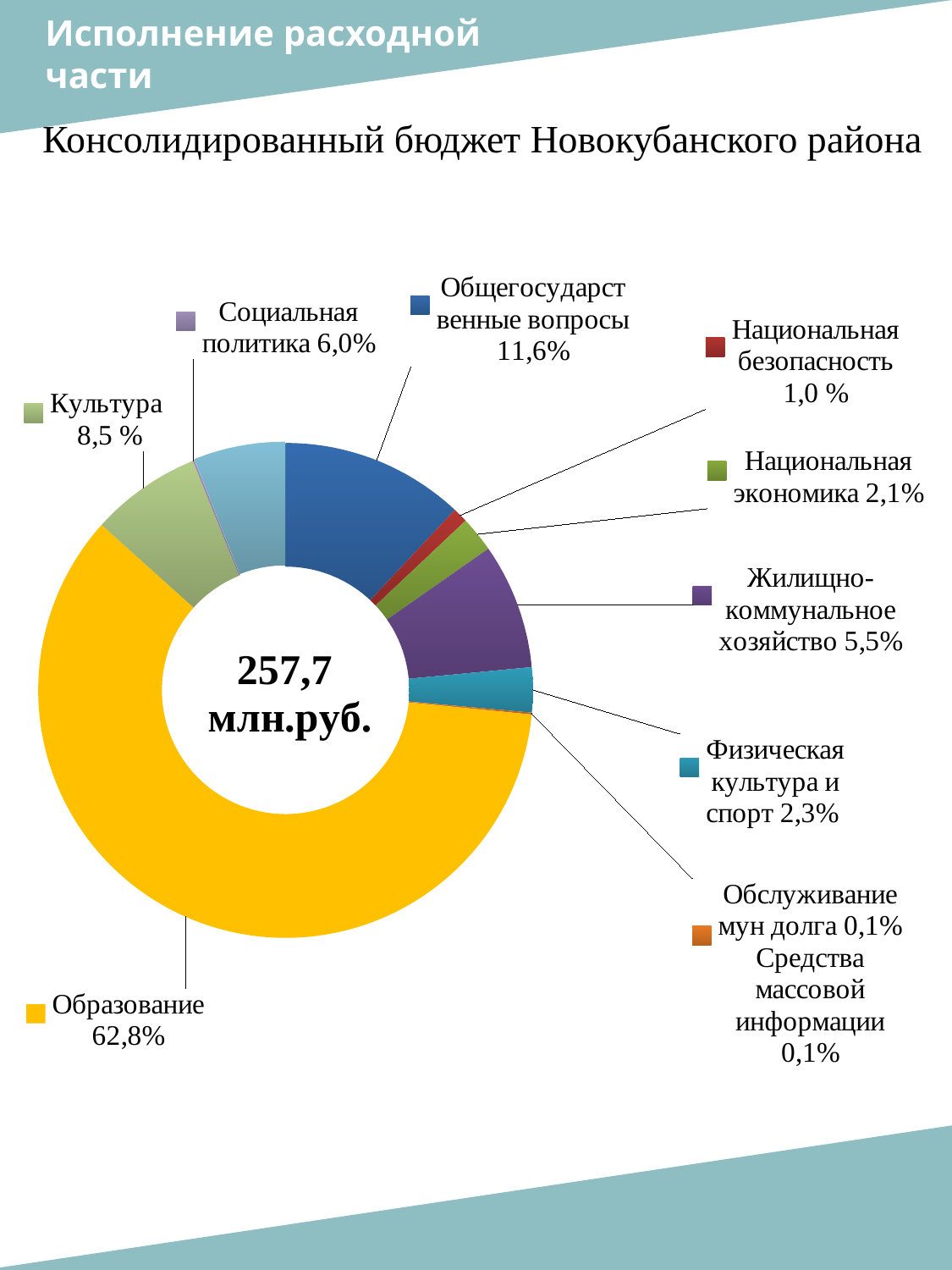
What total amount is shown in the centre of the chart? 257,7 млн.руб. Which category has the largest share of the budget? Образование What share of expenditure goes to Культура? 8,5 % Which category has a larger share: Социальная политика or Национальная экономика? Социальная политика What is the difference in share between Образование and Общегосударственные вопросы? 51,2% What is the difference in share between Культура and Социальная политика? 2,5% What share of expenditure goes to Физическая культура и спорт? 2,3% What kind of chart is shown on the slide? Doughnut (pie) chart What share of expenditure goes to Общегосударственные вопросы? 11,6% How many categories are shown in the chart? 10 What share of expenditure goes to Жилищно-коммунальное хозяйство? 5,5% What share of expenditure goes to Образование? 62,8%